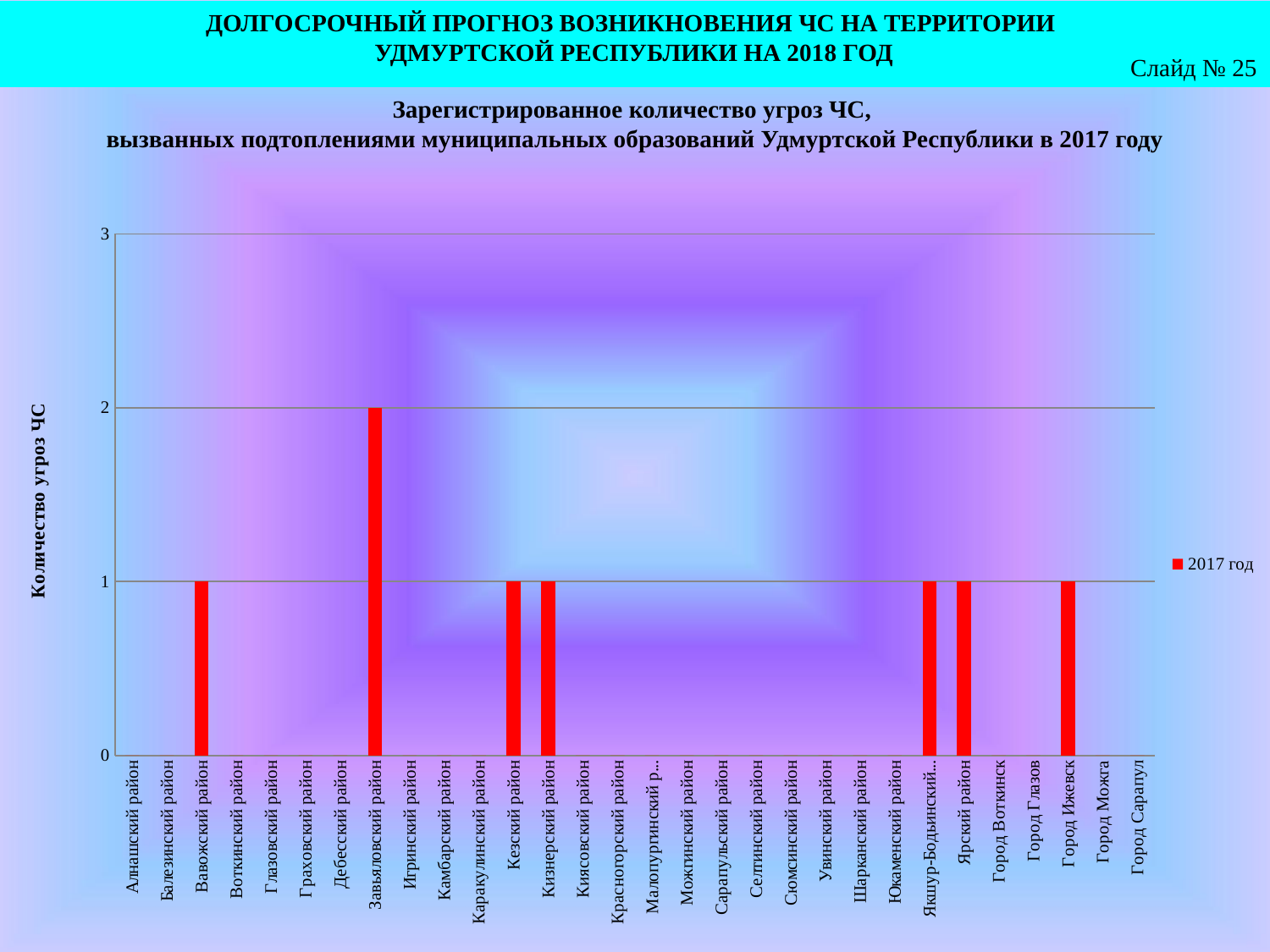
Which is larger, the value for Завьяловский район or the value for Кизнерский район? Завьяловский район What is the value for Кезский район? 1 What is the legend entry for the series shown? 2017 год Which municipality has the highest registered number of flood threats? Завьяловский район How many series does the legend list? 1 What is the value for Город Ижевск? 1 What is the difference between the values for Завьяловский район and Ярский район? 1 What is the value for Завьяловский район? 2 What is the value for Вавожский район? 1 How many municipalities (categories) are shown on the x axis? 30 What type of chart is shown on the slide? bar chart What is the value for Город Сарапул? 0